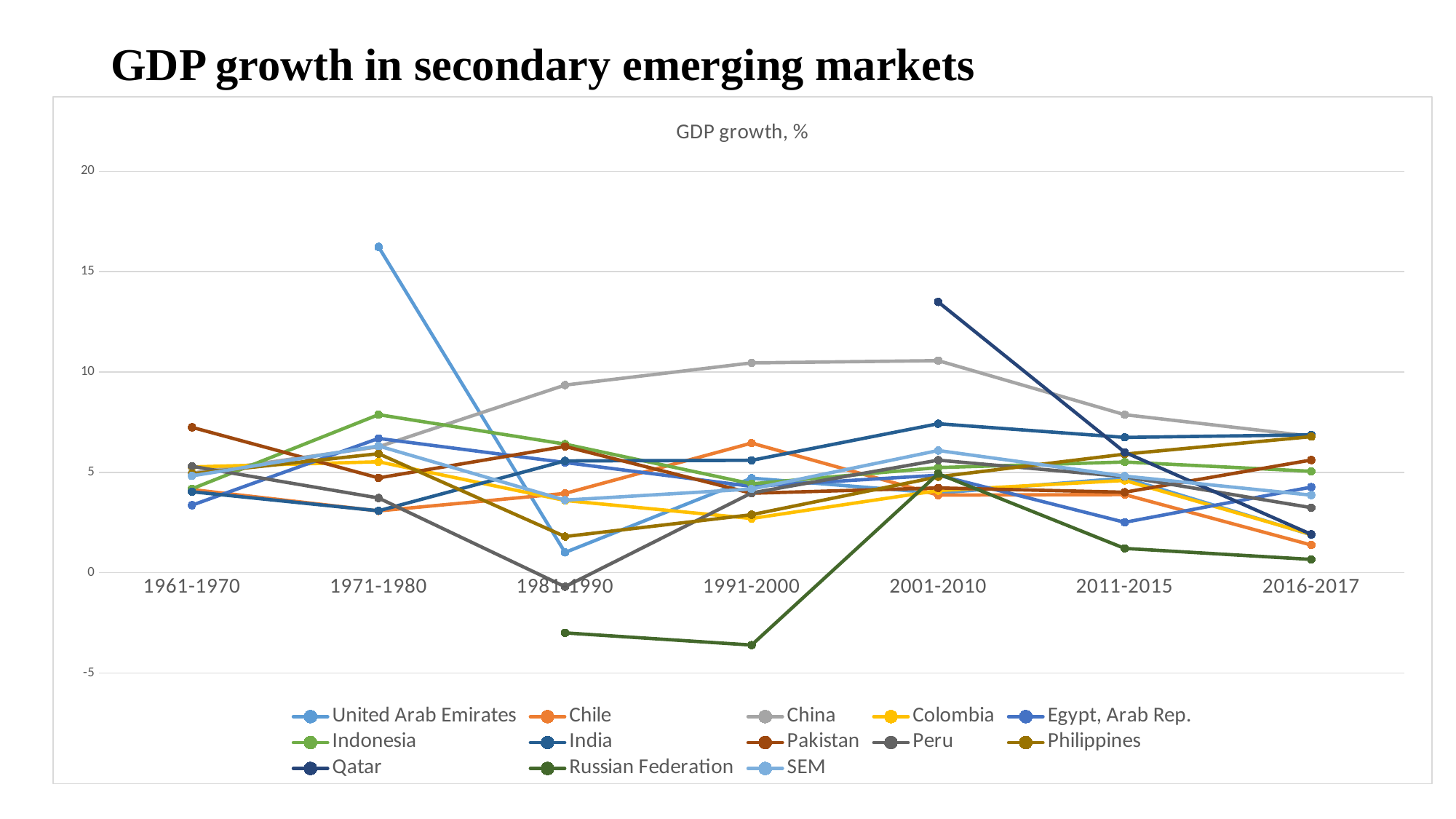
Does China's GDP growth rise or fall from 2001-2010 to 2016-2017? fall What kind of chart is shown on the slide? line chart How many time periods are shown on the x axis? 7 Is the value for Qatar in 2001-2010 greater or less than 10? greater Is the value for Russian Federation in 1991-2000 greater or less than 0? less What is the title shown inside the chart area? GDP growth, % Which country has the lowest GDP growth in 1991-2000? Russian Federation How many series does the legend list? 13 Which country has the highest GDP growth in 2001-2010? Qatar Which country has the highest GDP growth in 1991-2000? China Which country has the highest GDP growth in 1971-1980? United Arab Emirates Is the value for United Arab Emirates in 1971-1980 greater or less than 15? greater